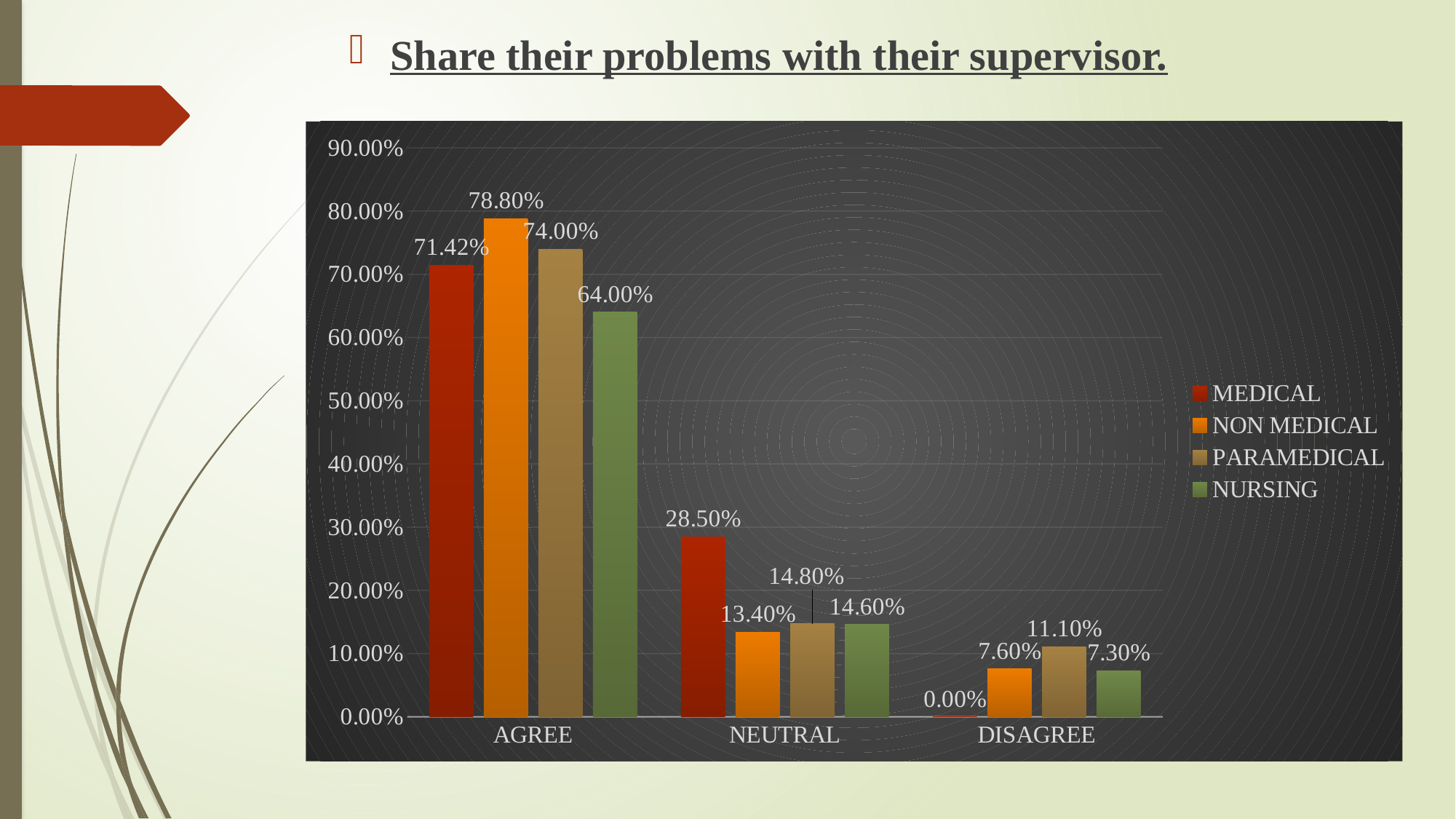
What is the value for MEDICAL in the NEUTRAL category? 28.50% What is the value for NON MEDICAL in the AGREE category? 78.80% How many categories are shown on the x axis? 3 What is the value for NURSING in the AGREE category? 64.00% Which colour represents the NURSING series in the legend? Green What is the value for PARAMEDICAL in the DISAGREE category? 11.10% Which series has the lowest value in the DISAGREE category? MEDICAL How many series does the legend list? 4 What kind of chart is shown on the slide? Bar chart In the NEUTRAL category, which is larger: the MEDICAL value or the NON MEDICAL value? MEDICAL Which series has the highest value in the AGREE category? NON MEDICAL What is the difference between the NON MEDICAL and MEDICAL values in the AGREE category? 7.38%